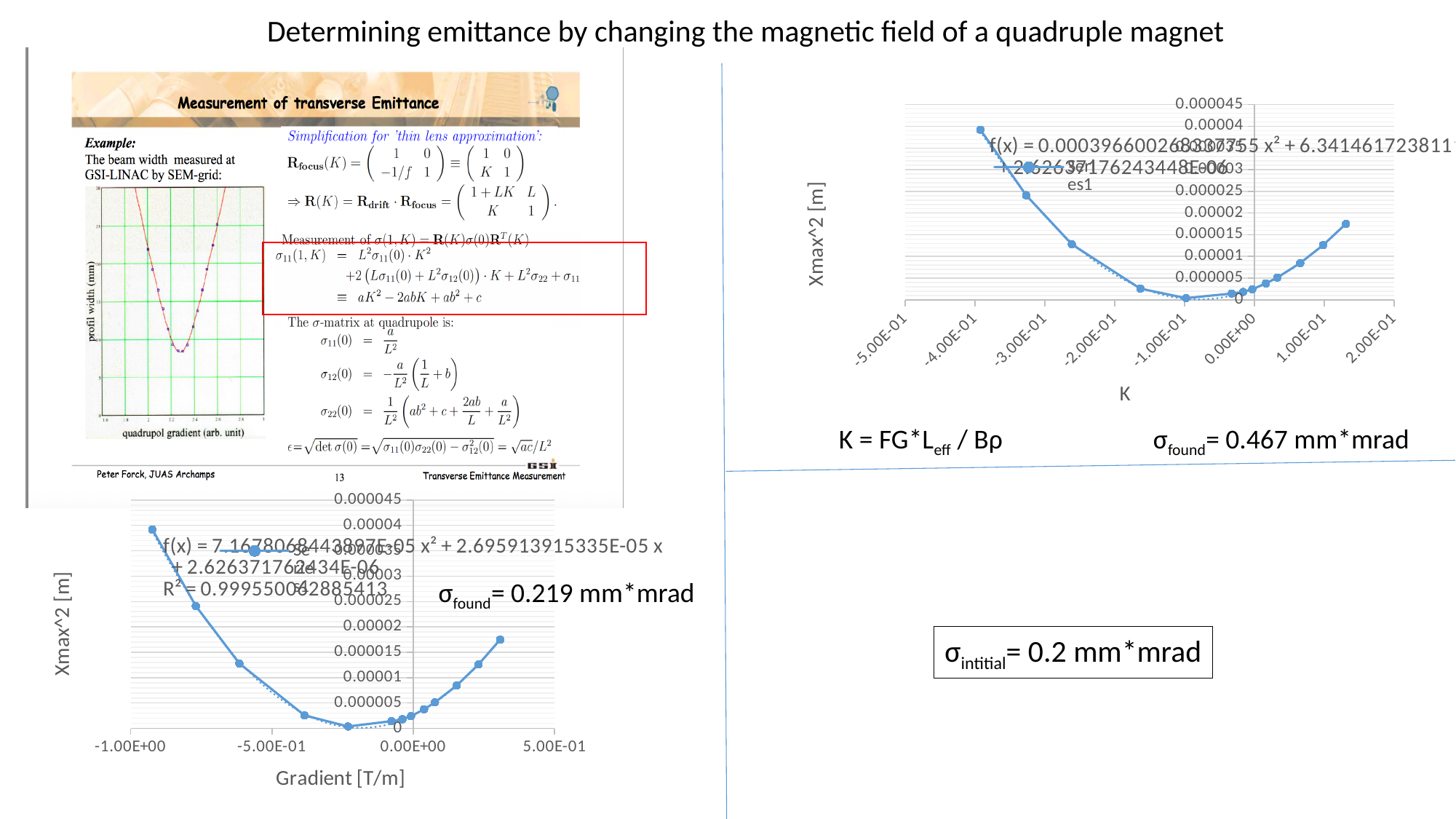
In the bottom-left chart (Gradient [T/m]), do the values rise or fall as the gradient increases from -1.00E+00 toward the minimum near -2.50E-01? fall What is the y-axis label of the bottom-left chart? Xmax^2 [m] In the top-right chart (K), is the value of the rightmost point greater or less than 0.000015? greater In the bottom-left chart (Gradient [T/m]), is the value of the rightmost point greater or less than 0.00002? less In the bottom-left chart (Gradient [T/m]), which point has the highest value: the leftmost point or the rightmost point? the leftmost point What kind of chart is the bottom-left chart with the x axis labelled Gradient [T/m]? line chart In the top-right chart (K), is the value of the leftmost point greater or less than 0.000035? greater What is the x-axis label of the top-right chart? K What is the highest tick value shown on the y axis of the top-right chart? 0.000045 In the top-right chart (K), which point has the highest value: the leftmost point or the rightmost point? the leftmost point In the top-right chart (K), do the values rise or fall as K increases from 0.00E+00 to 2.00E-01? rise